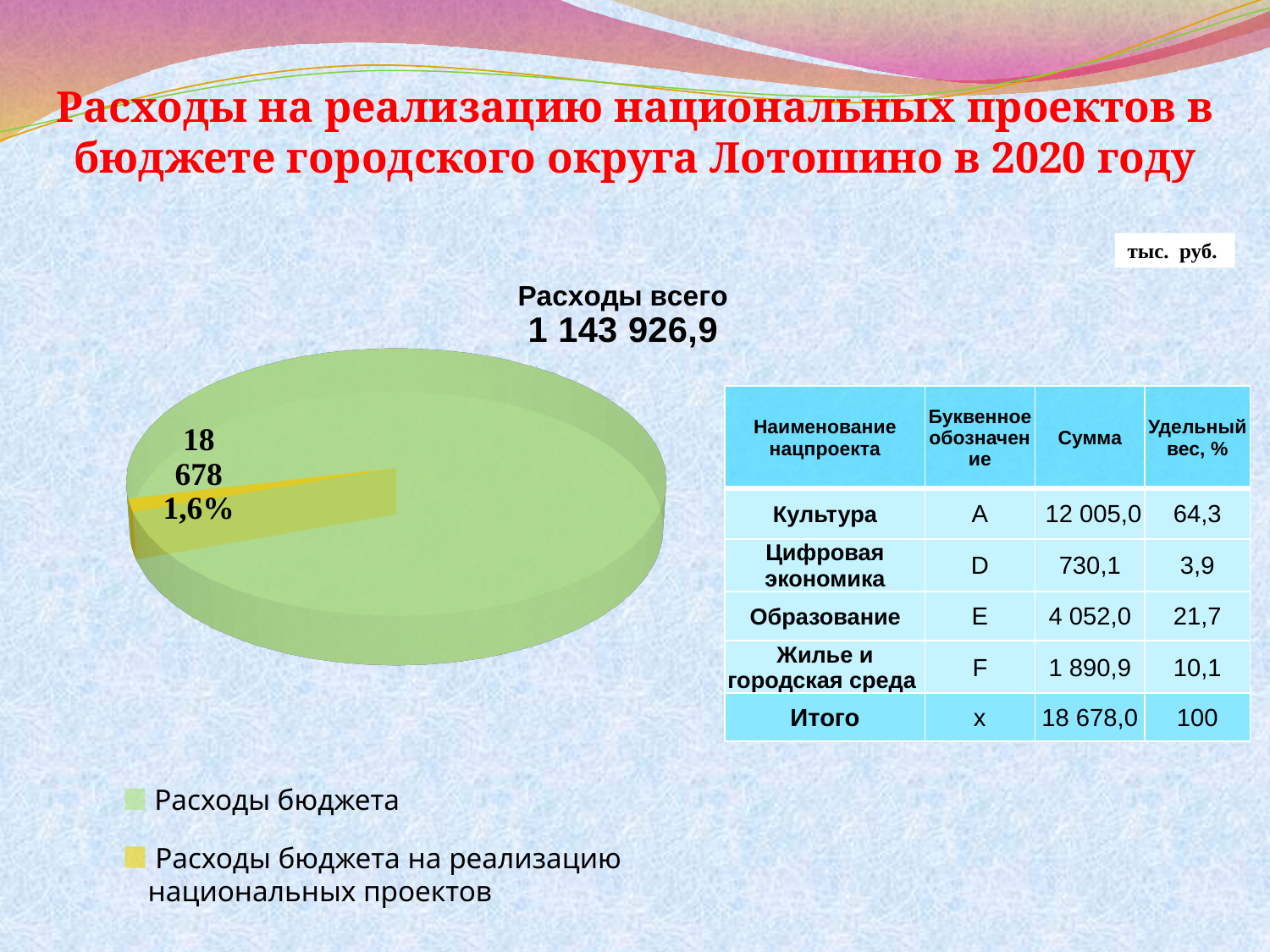
What kind of chart is shown on the slide? pie chart Which slice of the pie chart is the smallest? Расходы бюджета на реализацию национальных проектов How many slices does the pie chart have? 2 How many entries does the pie chart's legend list? 2 What value is labelled on the slice for "Расходы бюджета на реализацию национальных проектов"? 18 678 Which is larger in the pie chart: "Расходы бюджета" or "Расходы бюджета на реализацию национальных проектов"? Расходы бюджета What share of the pie does the slice "Расходы бюджета на реализацию национальных проектов" represent? 1,6% What colour is the slice for "Расходы бюджета на реализацию национальных проектов" in the pie chart? yellow Which slice of the pie chart is the largest? Расходы бюджета What total value is shown above the pie chart under "Расходы всего"? 1 143 926,9 In what units are the values on the slide given, according to the note in the top right? тыс. руб.